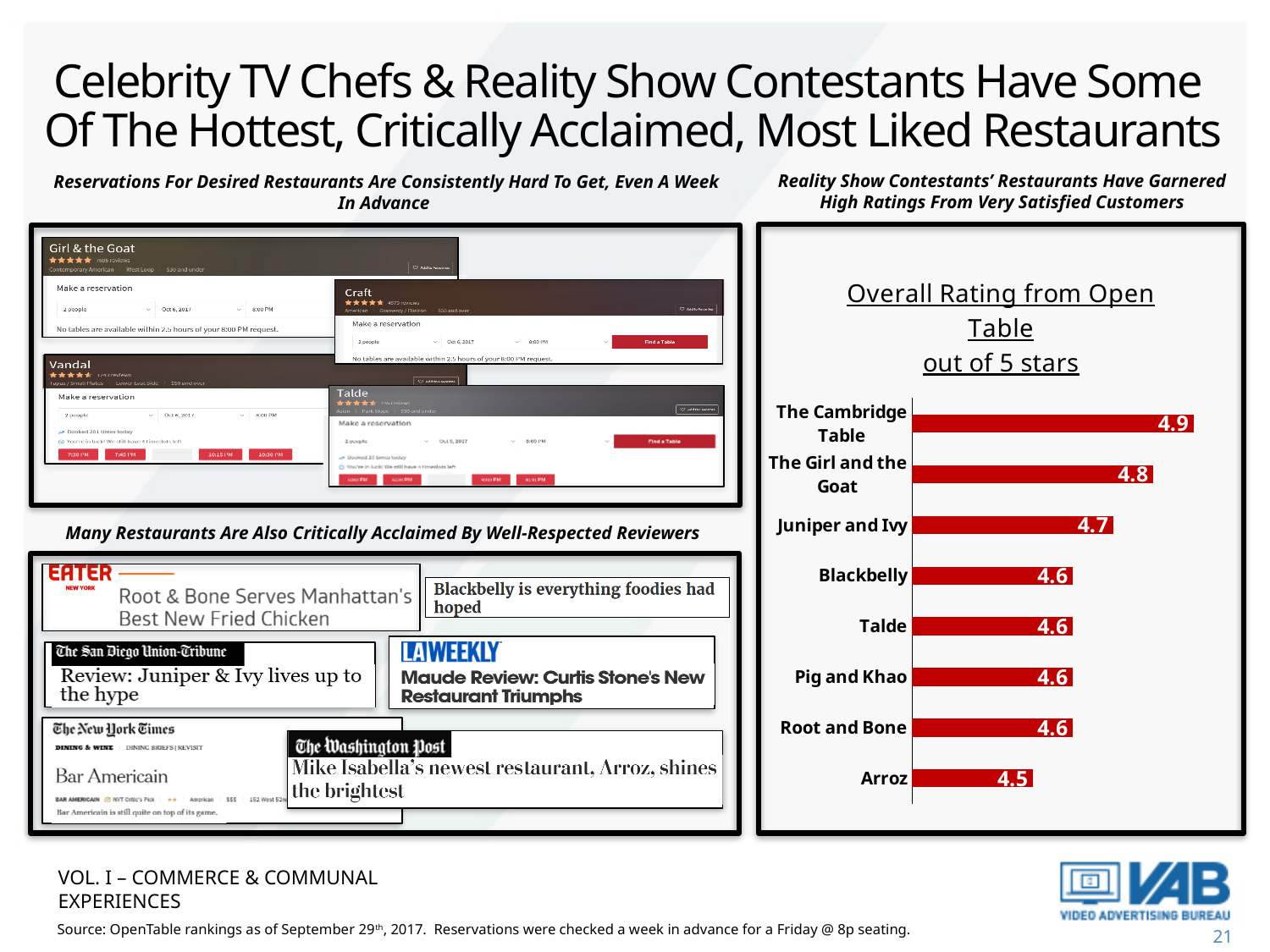
Which restaurant has the lowest overall Open Table rating in the chart? Arroz What is the difference between the ratings of The Cambridge Table and Arroz? 0.4 Which restaurant has the highest overall Open Table rating in the chart? The Cambridge Table What is the overall Open Table rating for Arroz? 4.5 What is the overall Open Table rating for Pig and Khao? 4.6 Which has a higher rating, Juniper and Ivy or Root and Bone? Juniper and Ivy How many restaurants are shown in the Open Table rating chart? 8 What kind of chart is used to show the Open Table ratings? Bar chart What is the overall Open Table rating for Juniper and Ivy? 4.7 What is the difference between the ratings of The Girl and the Goat and Blackbelly? 0.2 Out of how many stars are the Open Table ratings in the chart given? 5 stars What is the overall Open Table rating for The Cambridge Table? 4.9